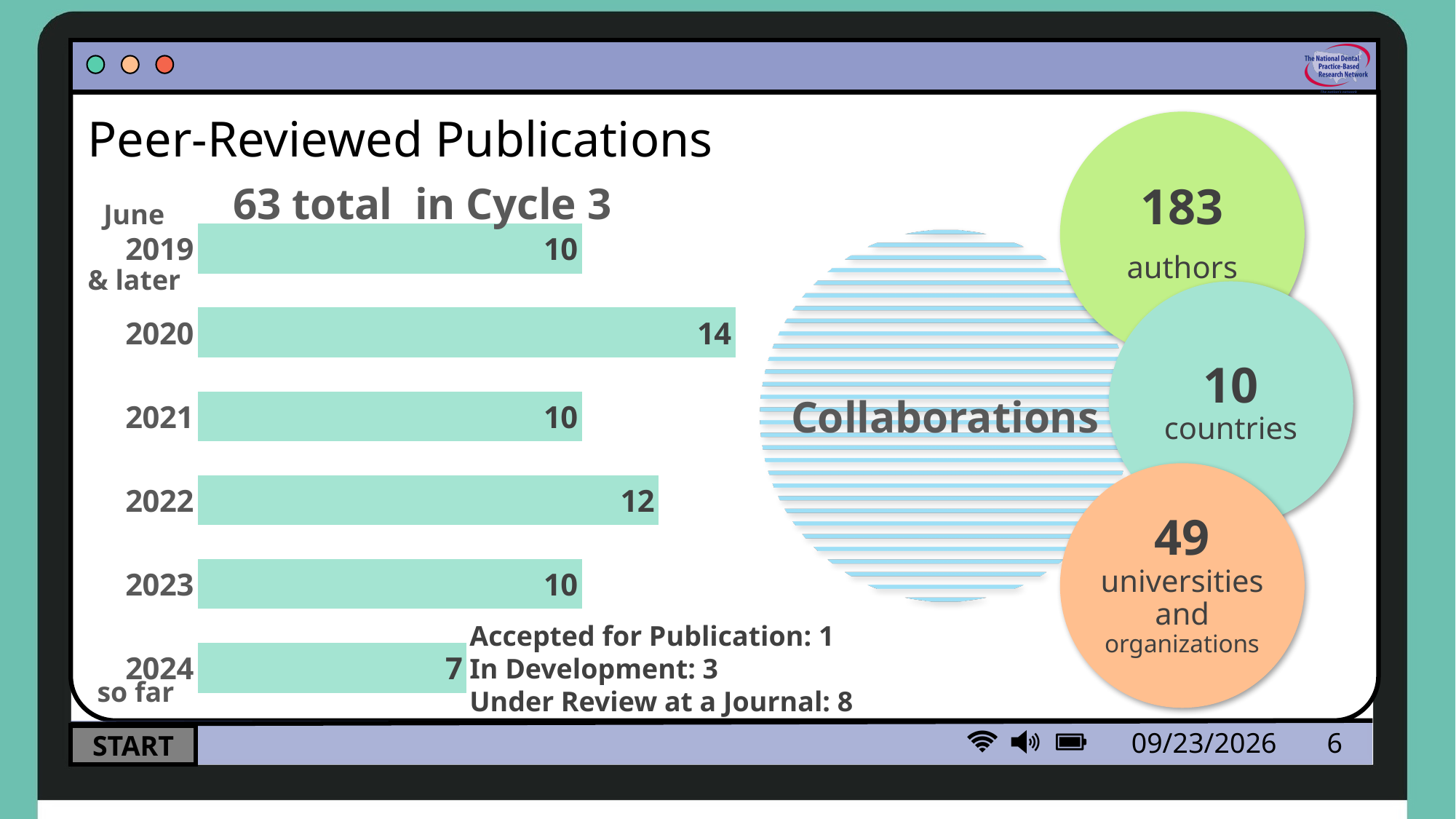
How many categories (bars) are shown in the bar chart? 6 What is the difference between the values for 2020 and 2024 so far? 7 Which year has the highest value in the bar chart? 2020 What is the value for 2022 in the bar chart? 12 What is the value for 2024 so far in the bar chart? 7 Which is larger, the value for 2022 or the value for 2023? 2022 What type of chart is shown on the slide? bar chart What is the value for 2020 in the bar chart? 14 What total is stated in the chart's heading? 63 total in Cycle 3 Which category has the lowest value in the bar chart? 2024 so far What is the value for June 2019 & later in the bar chart? 10 What is the difference between the values for 2022 and 2021? 2